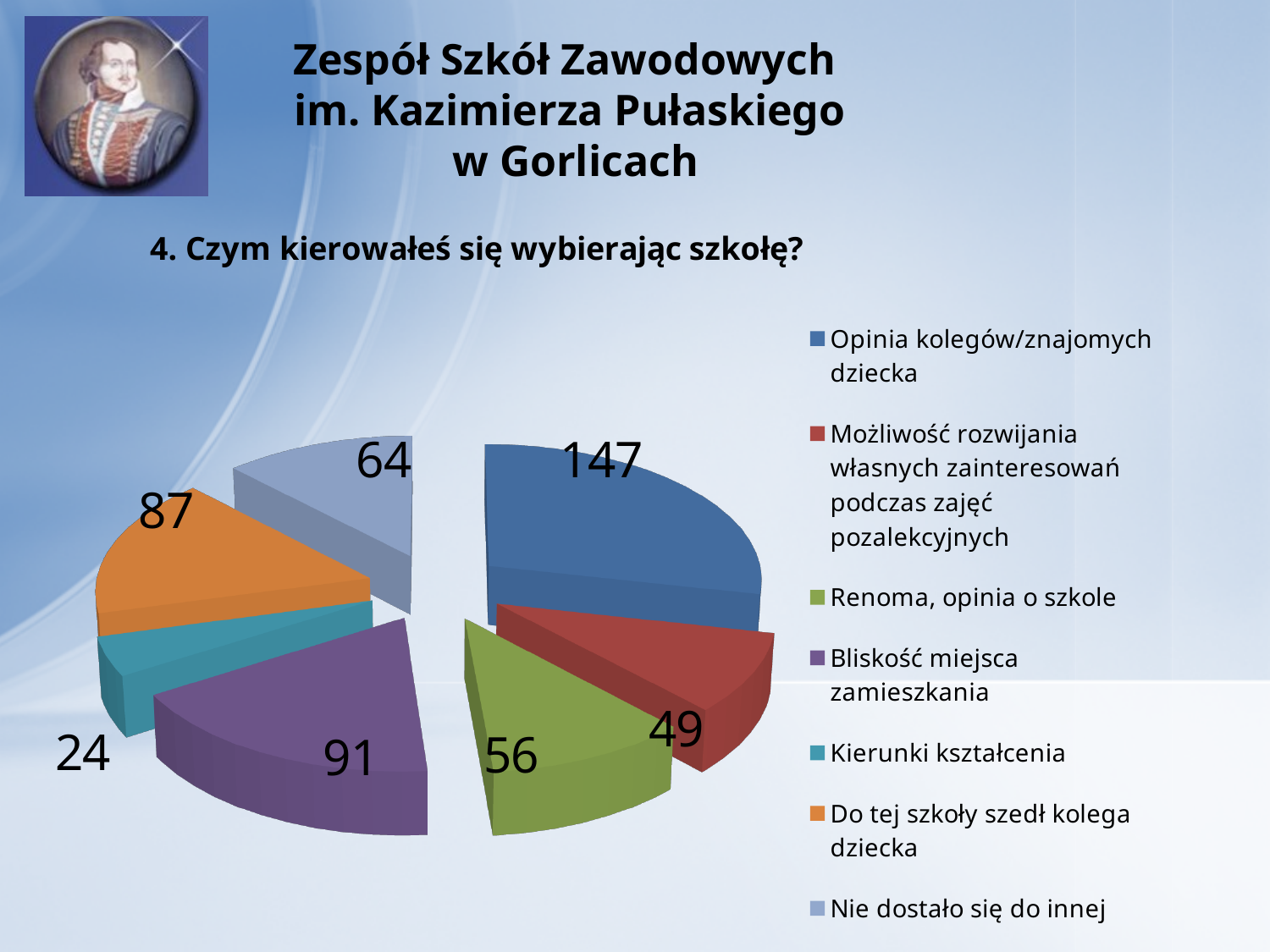
Which is larger: "Renoma, opinia o szkole" or "Możliwość rozwijania własnych zainteresowań podczas zajęć pozalekcyjnych"? Renoma, opinia o szkole What is the value for "Bliskość miejsca zamieszkania"? 91 What is the value for "Nie dostało się do innej"? 64 What type of chart is shown on the slide? Pie chart What is the difference between the values for "Opinia kolegów/znajomych dziecka" and "Bliskość miejsca zamieszkania"? 56 What colour is the slice for "Do tej szkoły szedł kolega dziecka"? Orange What is the total of all slices in the pie chart? 518 Which category has the lowest value? Kierunki kształcenia How many categories does the pie chart have? 7 What is the value for "Kierunki kształcenia"? 24 Which category has the highest value? Opinia kolegów/znajomych dziecka What is the value for "Opinia kolegów/znajomych dziecka"? 147